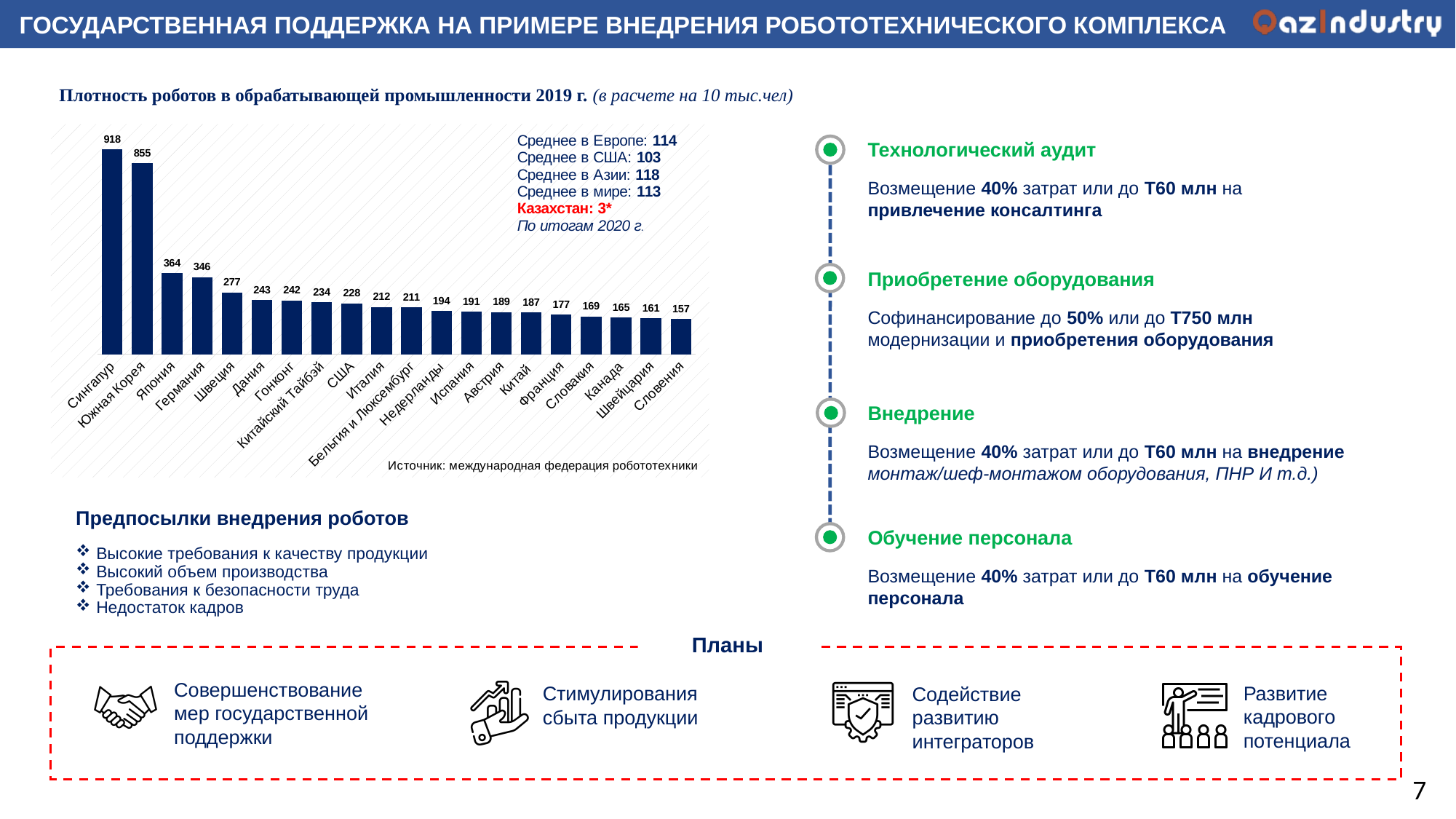
What is the robot density value shown for Сингапур? 918 What is the difference between the values for Сингапур and Южная Корея? 63 Do the values rise or fall from left to right along the x axis? Fall What is the value shown for США? 228 Which country has the highest robot density in the chart? Сингапур What is the value shown for Словения? 157 What type of chart is shown on the slide? Bar chart How many countries/regions are shown in the bar chart? 20 Which country has the lowest value in the chart? Словения Which has a higher value, Япония or Германия? Япония What is the title of the chart? Плотность роботов в обрабатывающей промышленности 2019 г. (в расчете на 10 тыс.чел) What is the value shown for Германия? 346